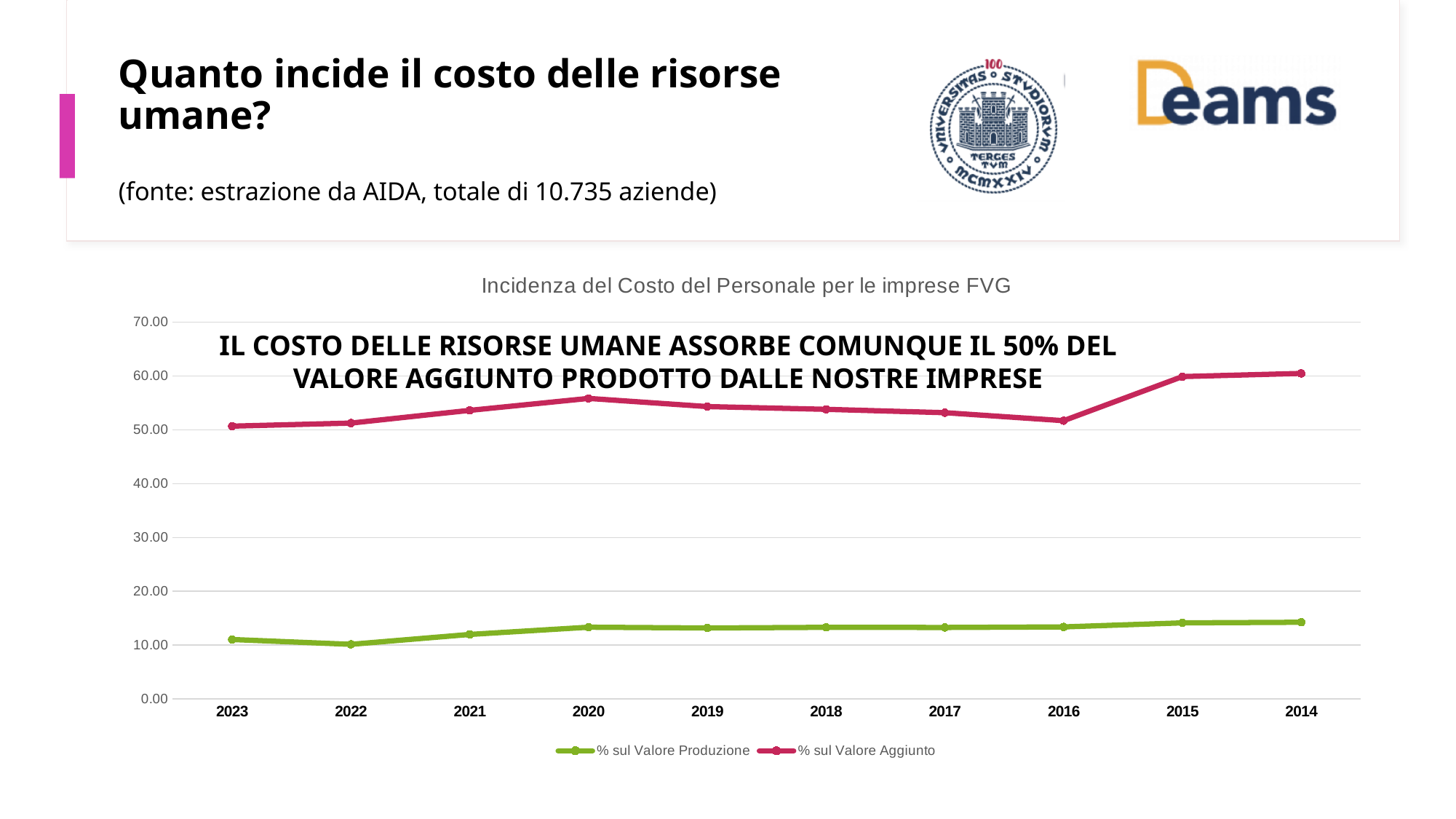
Is the value for 2014 in the '% sul Valore Produzione' series greater or less than 20? less How many years are plotted along the x axis of the chart? 10 Which year has the lowest value in the '% sul Valore Produzione' series? 2022 In the '% sul Valore Aggiunto' series, which is larger: the value for 2020 or the value for 2016? 2020 What kind of chart is shown on the slide? line chart Is the value for 2023 in the '% sul Valore Aggiunto' series greater or less than 60? less What is the title of the chart? Incidenza del Costo del Personale per le imprese FVG Is the value for 2020 in the '% sul Valore Aggiunto' series greater or less than 50? greater How many series does the chart legend list? 2 Which series is drawn in green in the chart? % sul Valore Produzione Moving along the x axis from 2023 to 2014, does the '% sul Valore Produzione' series overall rise or fall? rise